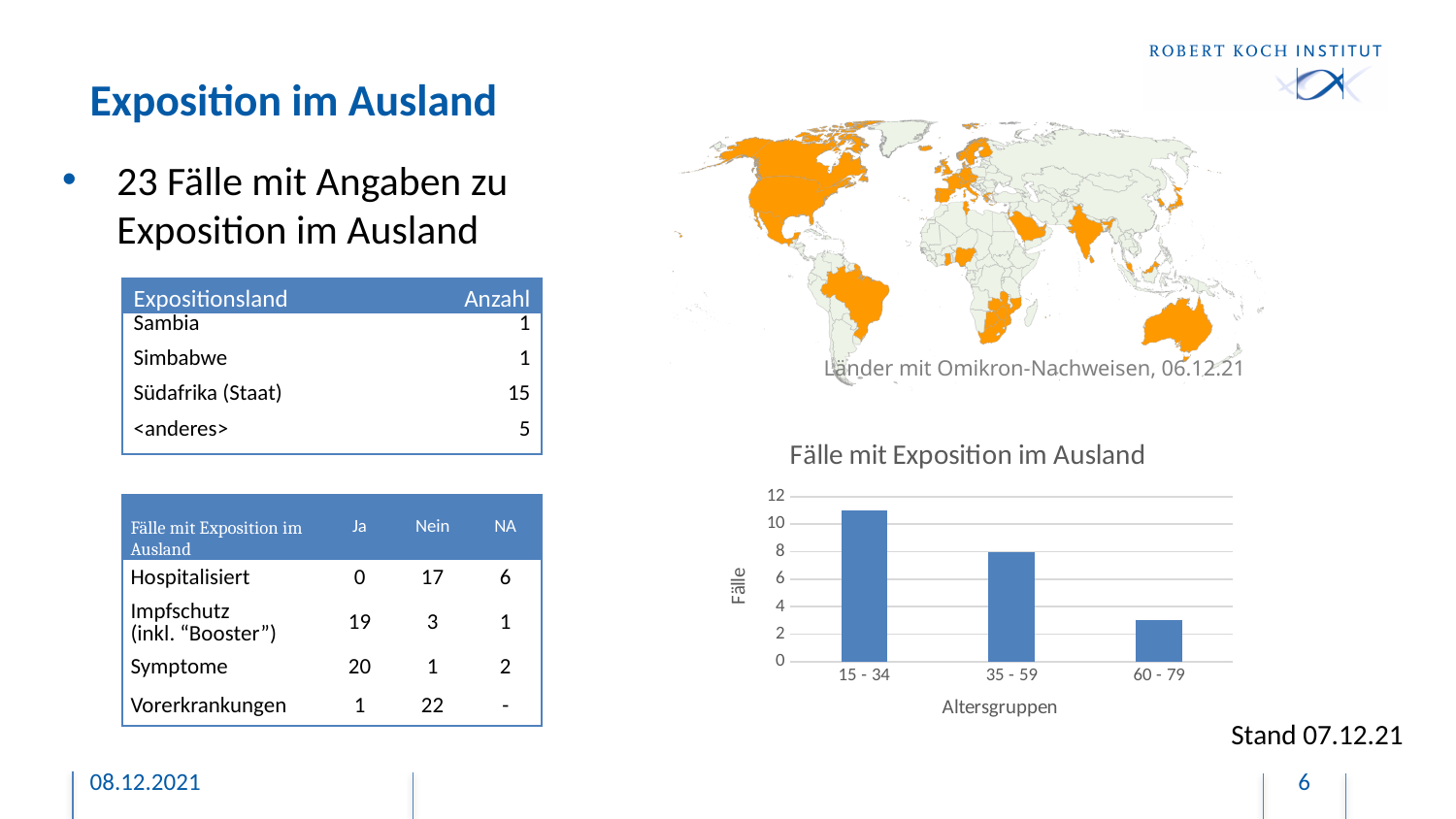
How many age groups are shown in the chart 'Fälle mit Exposition im Ausland'? 3 What kind of chart is 'Fälle mit Exposition im Ausland'? bar chart In the chart 'Fälle mit Exposition im Ausland', is the value for the 60 - 79 age group greater or less than 2? greater In the chart 'Fälle mit Exposition im Ausland', which age group has the lowest number of cases? 60 - 79 What is the label of the y axis in the chart 'Fälle mit Exposition im Ausland'? Fälle In the chart 'Fälle mit Exposition im Ausland', is the value for the 15 - 34 age group greater or less than 12? less In the chart 'Fälle mit Exposition im Ausland', is the value for the 60 - 79 age group greater or less than 4? less In the chart 'Fälle mit Exposition im Ausland', which age group has more cases, 35 - 59 or 60 - 79? 35 - 59 In the chart 'Fälle mit Exposition im Ausland', do the values rise or fall as the age groups increase along the x axis? fall In the chart 'Fälle mit Exposition im Ausland', which age group has the highest number of cases? 15 - 34 What is the label of the x axis in the chart 'Fälle mit Exposition im Ausland'? Altersgruppen